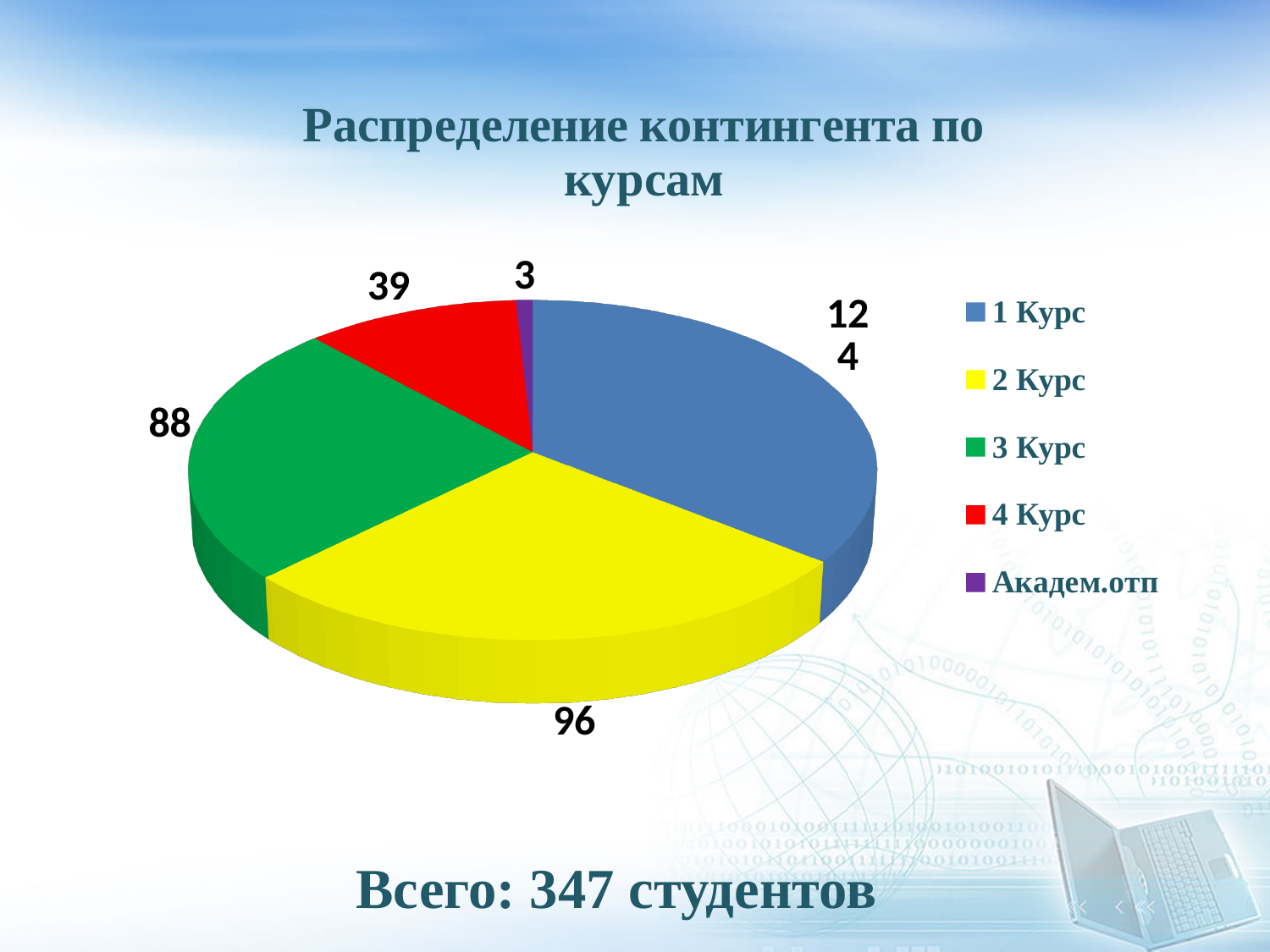
What is the title of the chart? Распределение контингента по курсам How many categories does the legend list? 5 Which category has the largest slice of the pie? 1 Курс What is the value for Академ.отп? 3 Which is larger, the value for 3 Курс or the value for 4 Курс? 3 Курс What is the value for 4 Курс? 39 What kind of chart is shown on the slide? pie chart What is the value for 3 Курс? 88 Which category has the smallest slice of the pie? Академ.отп What is the value for 1 Курс? 124 What is the value for 2 Курс? 96 What is the difference between the values for 2 Курс and 3 Курс? 8